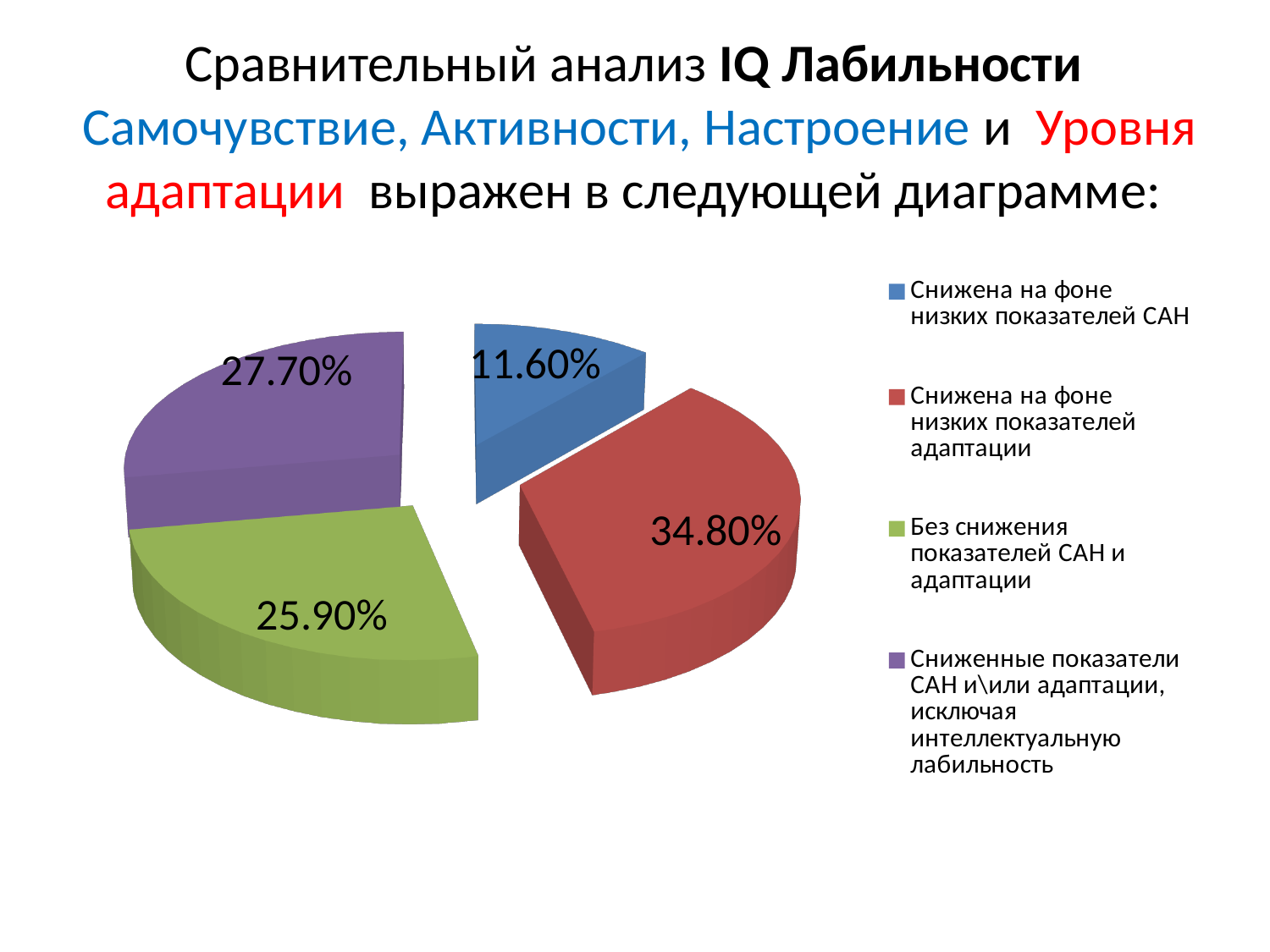
What is the value for "Снижена на фоне низких показателей адаптации"? 34.80% Which is larger: the value for "Без снижения показателей САН и адаптации" or the value for "Сниженные показатели САН и\или адаптации, исключая интеллектуальную лабильность"? Сниженные показатели САН и\или адаптации, исключая интеллектуальную лабильность What is the value for "Сниженные показатели САН и\или адаптации, исключая интеллектуальную лабильность"? 27.70% What colour is the slice labelled 27.70%? Purple What kind of chart is shown on the slide? Pie chart What is the value for "Снижена на фоне низких показателей САН"? 11.60% What colour is the slice for "Снижена на фоне низких показателей адаптации"? Red Which category has the smallest share of the pie? Снижена на фоне низких показателей САН How many slices does the pie chart have? 4 Which category has the largest share of the pie? Снижена на фоне низких показателей адаптации What is the value for "Без снижения показателей САН и адаптации"? 25.90% What is the difference between the values for "Снижена на фоне низких показателей адаптации" and "Снижена на фоне низких показателей САН"? 23.20%